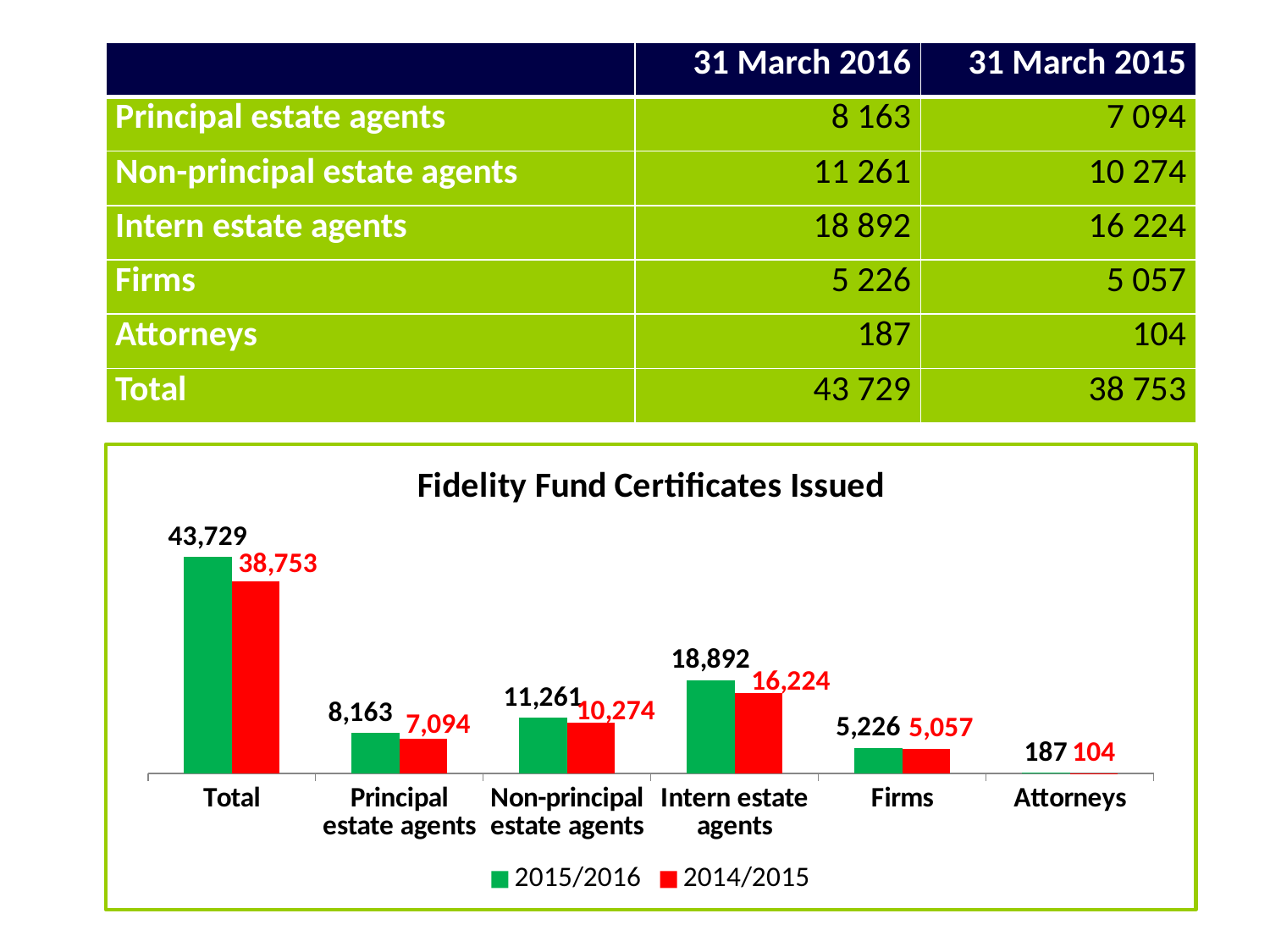
What is the title of the chart? Fidelity Fund Certificates Issued What type of chart is shown on the slide? bar chart How many categories are shown on the x axis of the chart? 6 In the chart, is the 2015/2016 value for Non-principal estate agents larger or smaller than the 2014/2015 value? larger Which category has the lowest 2014/2015 value in the chart? Attorneys What is the 2015/2016 value for Intern estate agents in the chart? 18,892 What is the difference between the 2015/2016 and 2014/2015 values for Principal estate agents in the chart? 1,069 What is the 2015/2016 value for Attorneys in the chart? 187 What is the 2014/2015 value for Firms in the chart? 5,057 Excluding Total, which category has the highest 2015/2016 value in the chart? Intern estate agents Which colour represents the 2014/2015 series in the chart? red How many series does the chart legend list? 2